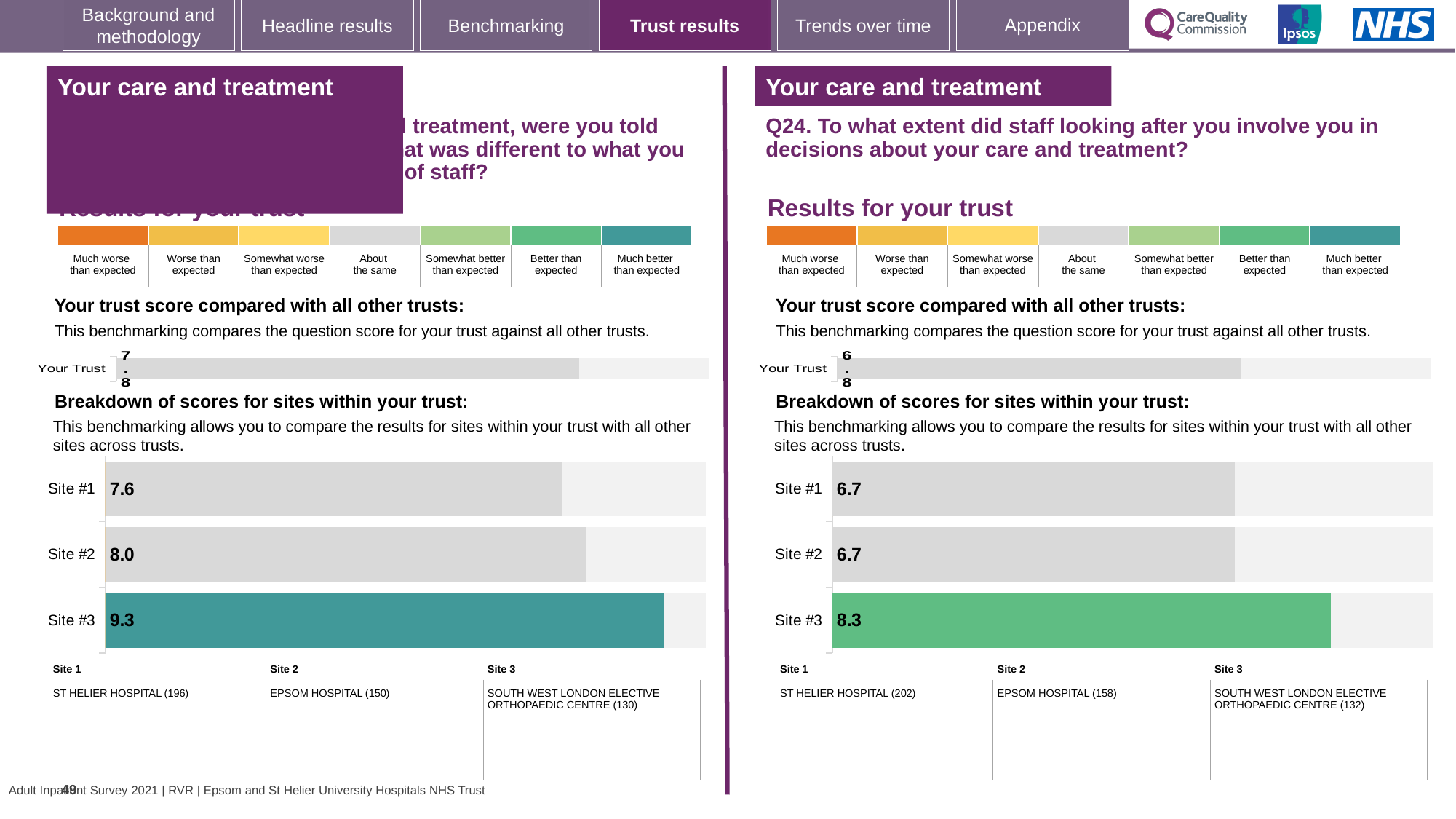
How many sites are shown in the site breakdown chart on the left-hand side of the slide? 3 On the right-hand chart (Q24), what is the difference between the scores for Site #3 and Site #2? 1.6 On the right-hand chart (Q24), what is the score for Site #1? 6.7 On the left-hand chart, which site has the lowest score? Site #1 On the right-hand chart (Q24), is the score for Site #1 larger or smaller than the score for Site #3? smaller On the left-hand chart, what is the difference between the scores for Site #3 and Site #1? 1.7 On the left-hand chart, which site has the highest score? Site #3 What kind of chart is used for the breakdown of scores for sites on the right-hand side of the slide? bar chart On the right-hand chart (Q24), which site has the highest score? Site #3 On the right-hand chart (Q24), what is the score for Site #3? 8.3 On the left-hand chart, what is the score for Site #2? 8.0 On the left-hand chart, what is the score for Site #1? 7.6